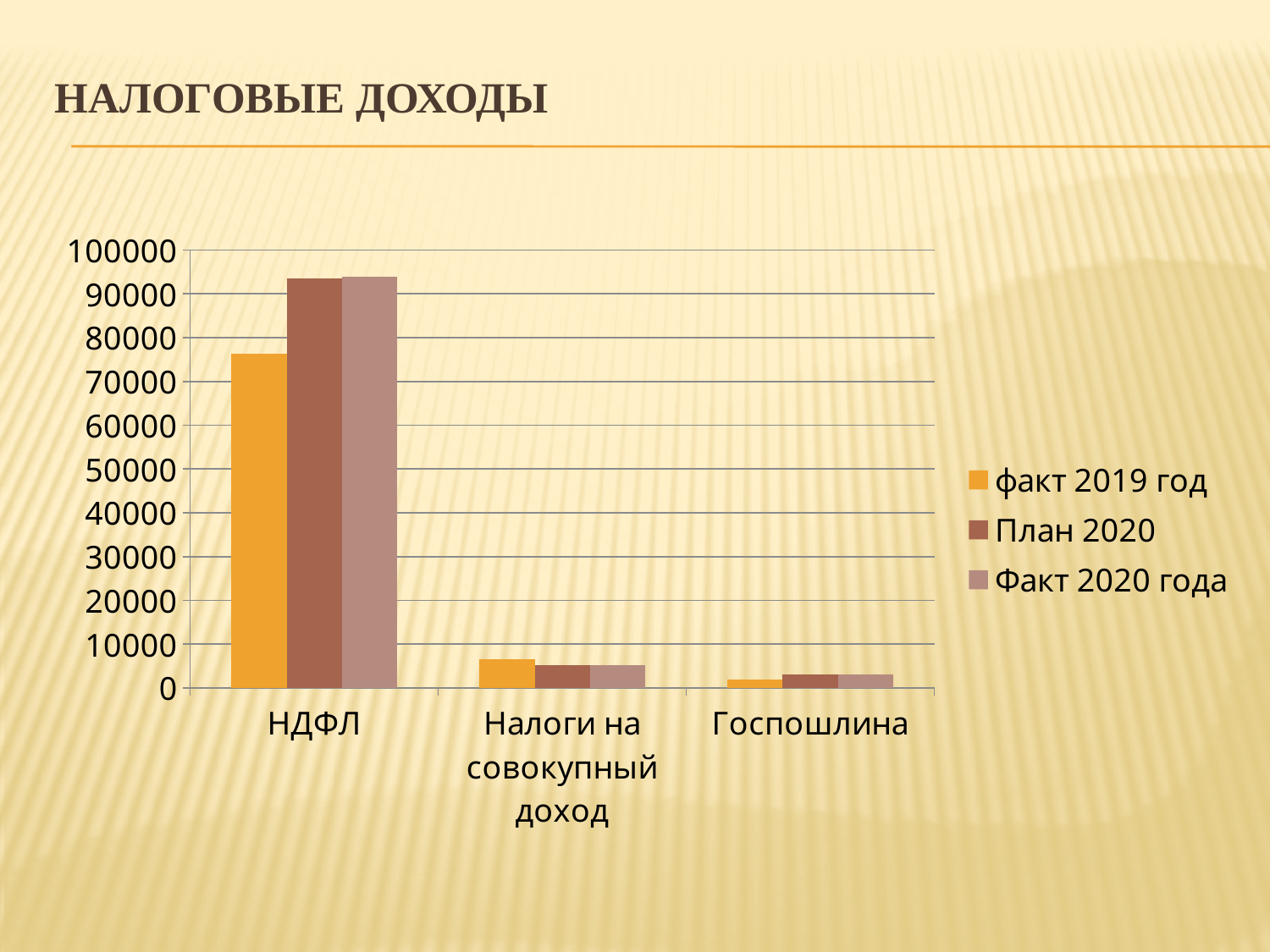
How many categories are shown on the x axis of the chart? 3 Is the value for План 2020 for НДФЛ greater or less than 90000? greater For НДФЛ, which is larger: факт 2019 год or План 2020? План 2020 Which category has the lowest values in the chart? Госпошлина Which category has the highest values in the chart? НДФЛ What is the title of the slide containing the chart? НАЛОГОВЫЕ ДОХОДЫ Do the values for факт 2019 год rise or fall from left to right along the x axis? fall Is the value for факт 2019 год for НДФЛ greater or less than 70000? greater How many series does the chart legend list? 3 What kind of chart is shown on the slide? bar chart Is the value for факт 2019 год for Налоги на совокупный доход greater or less than 10000? less For Налоги на совокупный доход, which is larger: факт 2019 год or Факт 2020 года? факт 2019 год